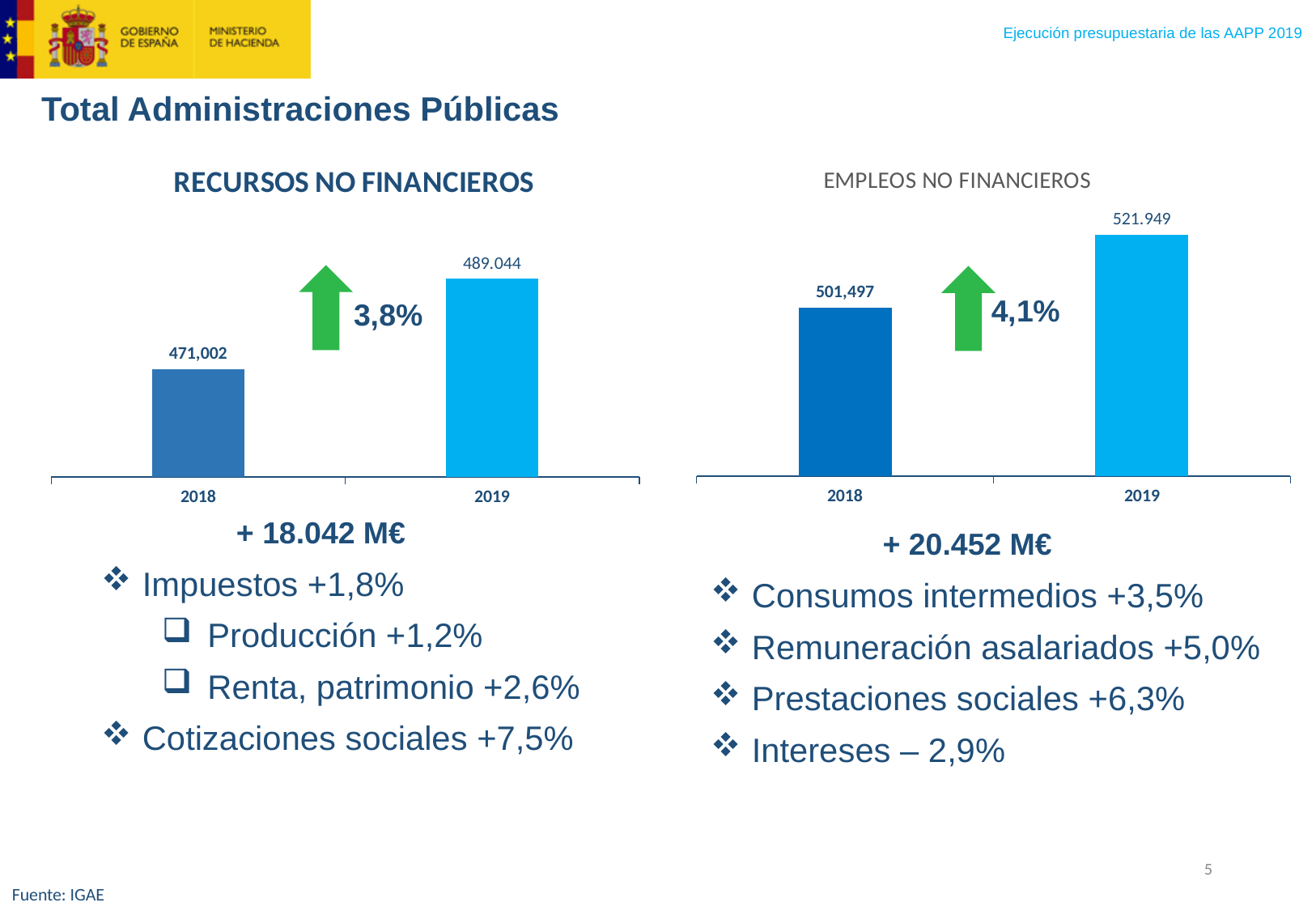
In the RECURSOS NO FINANCIEROS chart, by how much does the value increase from 2018 to 2019? 18.042 How many bars are shown in the RECURSOS NO FINANCIEROS chart? 2 In the EMPLEOS NO FINANCIEROS chart, is the value for 2019 larger or smaller than the value for 2018? larger What kind of chart is the EMPLEOS NO FINANCIEROS chart? bar chart In the EMPLEOS NO FINANCIEROS chart, what is the value for 2019? 521.949 In the RECURSOS NO FINANCIEROS chart, what is the value for 2018? 471,002 In the RECURSOS NO FINANCIEROS chart, which year has the higher value? 2019 In the EMPLEOS NO FINANCIEROS chart, what is the value for 2018? 501,497 In the EMPLEOS NO FINANCIEROS chart, which year has the lower value? 2018 What percentage change is shown next to the green arrow in the RECURSOS NO FINANCIEROS chart? 3,8% In the RECURSOS NO FINANCIEROS chart, what is the value for 2019? 489.044 In the EMPLEOS NO FINANCIEROS chart, by how much does the value increase from 2018 to 2019? 20.452